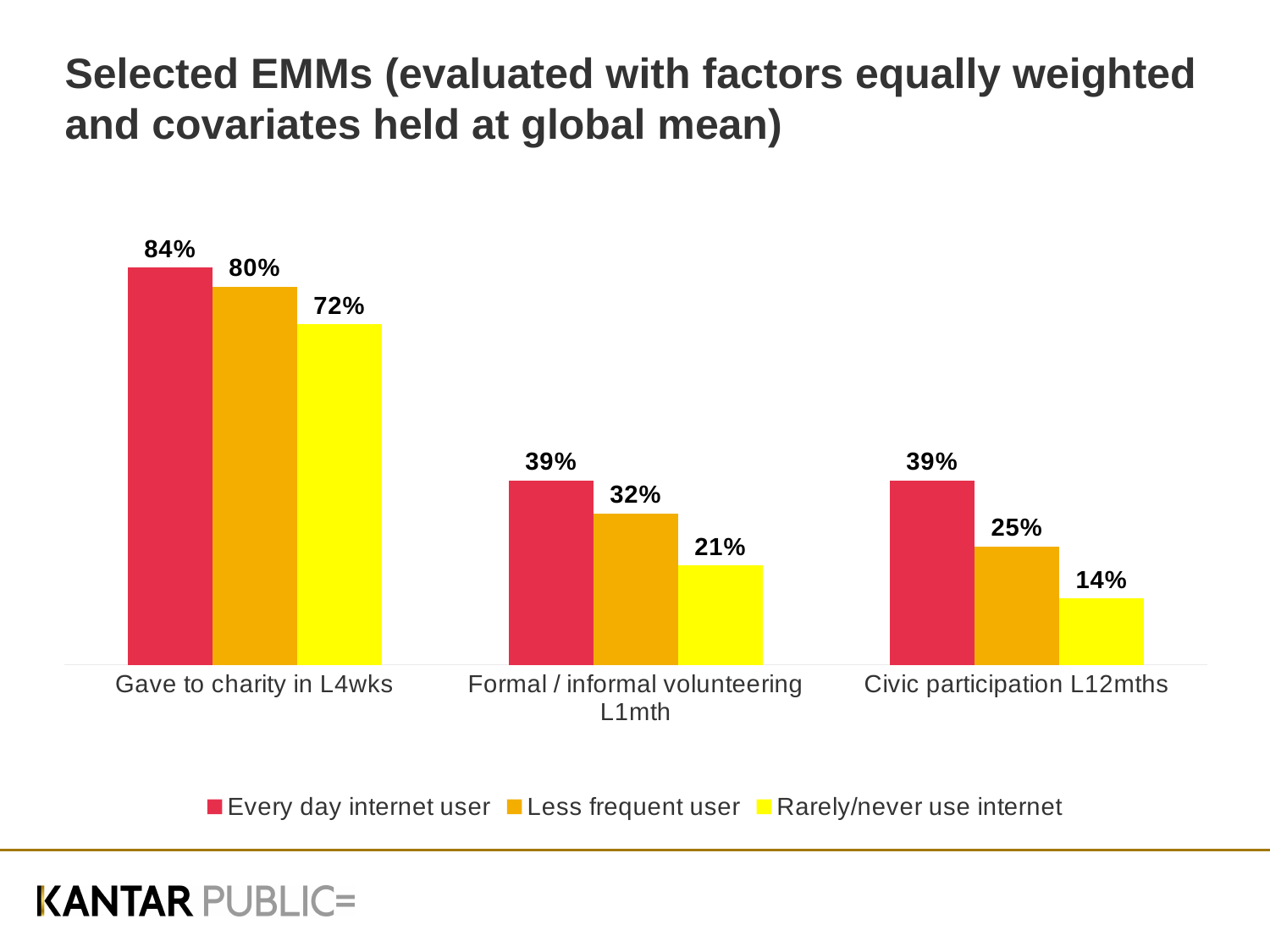
What is the difference between 'Every day internet user' and 'Rarely/never use internet' in the 'Civic participation L12mths' category? 25% How many series does the legend list? 3 Which is larger: 'Rarely/never use internet' for 'Formal / informal volunteering L1mth' or 'Rarely/never use internet' for 'Civic participation L12mths'? Formal / informal volunteering L1mth What is the value for 'Rarely/never use internet' in the 'Civic participation L12mths' category? 14% Which series is shown in yellow in the legend? Rarely/never use internet What is the difference between 'Every day internet user' and 'Less frequent user' in the 'Gave to charity in L4wks' category? 4% Which category has the lowest value for 'Less frequent user'? Civic participation L12mths What is the value for 'Less frequent user' in the 'Formal / informal volunteering L1mth' category? 32% What kind of chart is shown on the slide? Bar chart Which category has the highest value for 'Rarely/never use internet'? Gave to charity in L4wks How many categories are shown on the x axis? 3 What is the value for 'Every day internet user' in the 'Gave to charity in L4wks' category? 84%